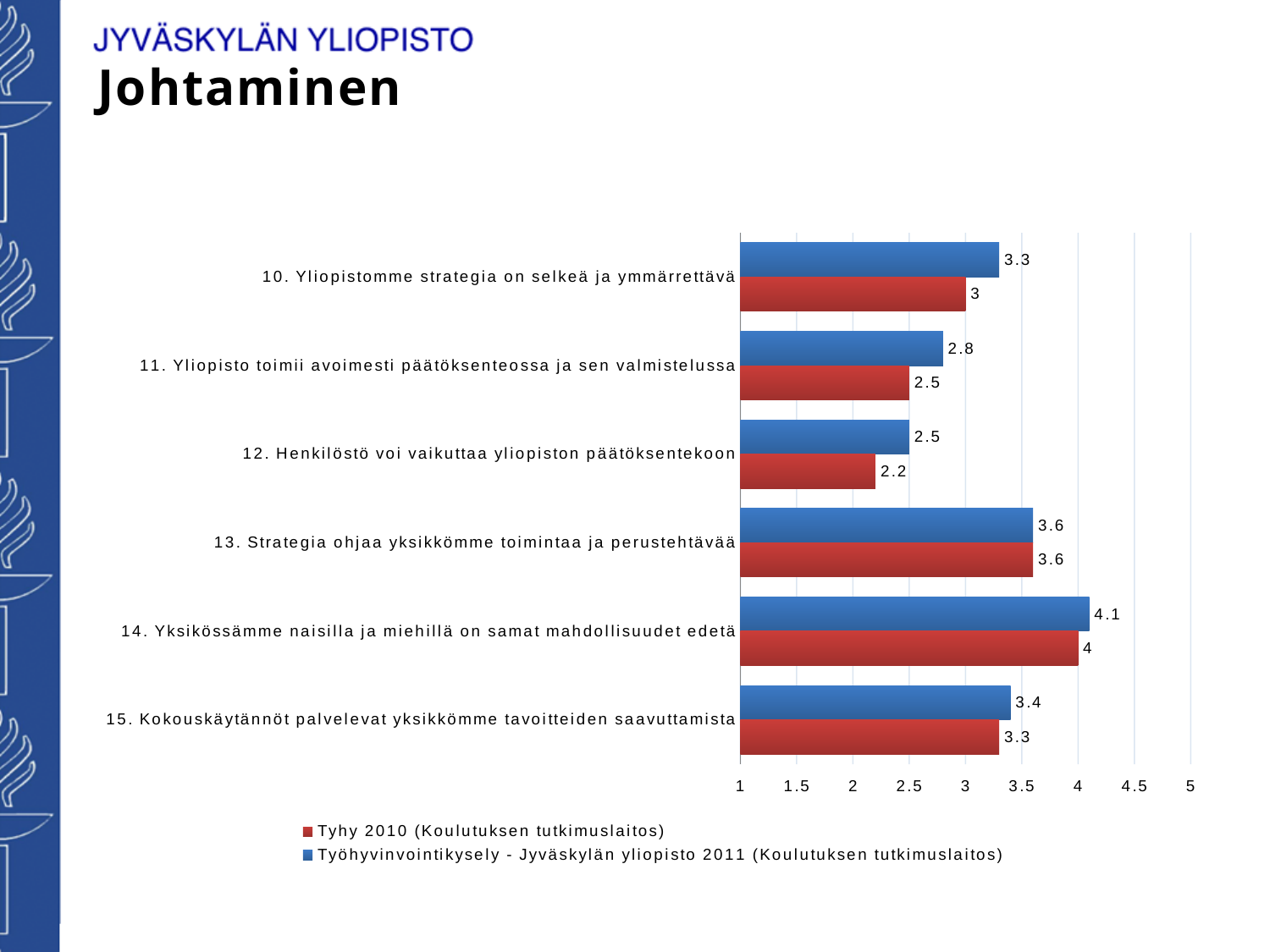
How many series does the legend list? 2 For '15. Kokouskäytännöt palvelevat yksikkömme tavoitteiden saavuttamista', which series has the larger value, Tyhy 2010 or Työhyvinvointikysely 2011? Työhyvinvointikysely - Jyväskylän yliopisto 2011 Which category has the lowest value in the Tyhy 2010 series? 12. Henkilöstö voi vaikuttaa yliopiston päätöksentekoon Which colour represents the Tyhy 2010 series in the chart? Red What is the value for '10. Yliopistomme strategia on selkeä ja ymmärrettävä' in the Tyhy 2010 series? 3 What kind of chart is shown on the slide? Bar chart How many categories (statements) are plotted in the chart? 6 What is the value for '12. Henkilöstö voi vaikuttaa yliopiston päätöksentekoon' in the Tyhy 2010 series? 2.2 Is the Tyhy 2010 value for '13. Strategia ohjaa yksikkömme toimintaa ja perustehtävää' greater or less than 3? greater Which category has the highest value in the Työhyvinvointikysely - Jyväskylän yliopisto 2011 series? 14. Yksikössämme naisilla ja miehillä on samat mahdollisuudet edetä What is the value for '14. Yksikössämme naisilla ja miehillä on samat mahdollisuudet edetä' in the Työhyvinvointikysely - Jyväskylän yliopisto 2011 series? 4.1 What is the difference between the 2011 and 2010 values for '11. Yliopisto toimii avoimesti päätöksenteossa ja sen valmistelussa'? 0.3